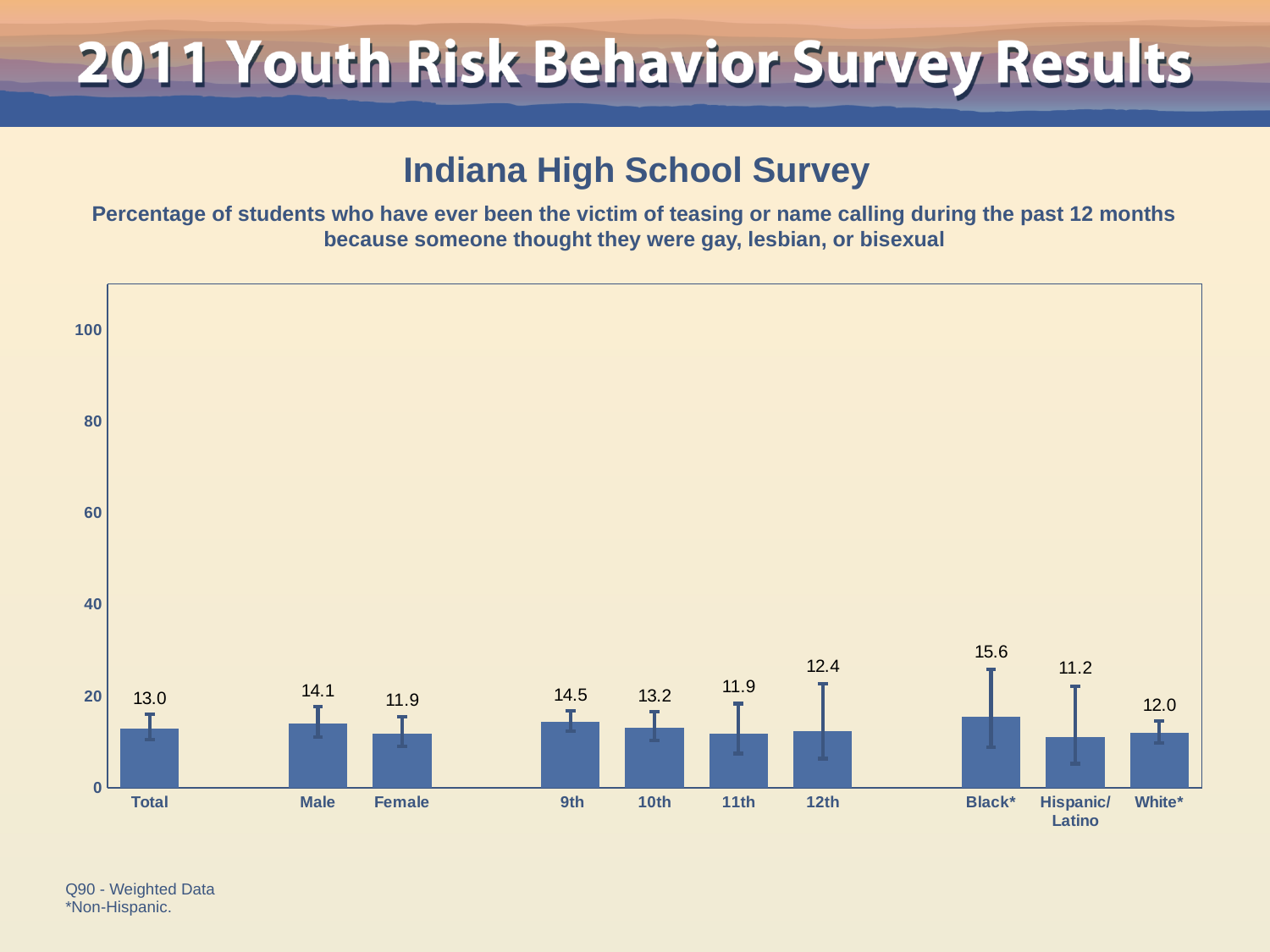
What is the difference between the values for Male and Female? 2.2 Is the value for White* greater or less than 20? less Which is larger, the value for 9th or the value for 10th? 9th Which category has the lowest value? Hispanic/Latino What is the title of the survey shown above the chart? Indiana High School Survey Which category has the highest value? Black* What is the value for 12th? 12.4 What is the value for Male? 14.1 What is the value for Total? 13.0 What kind of chart is this? bar chart What is the value for Hispanic/Latino? 11.2 How many categories are shown on the x axis? 10